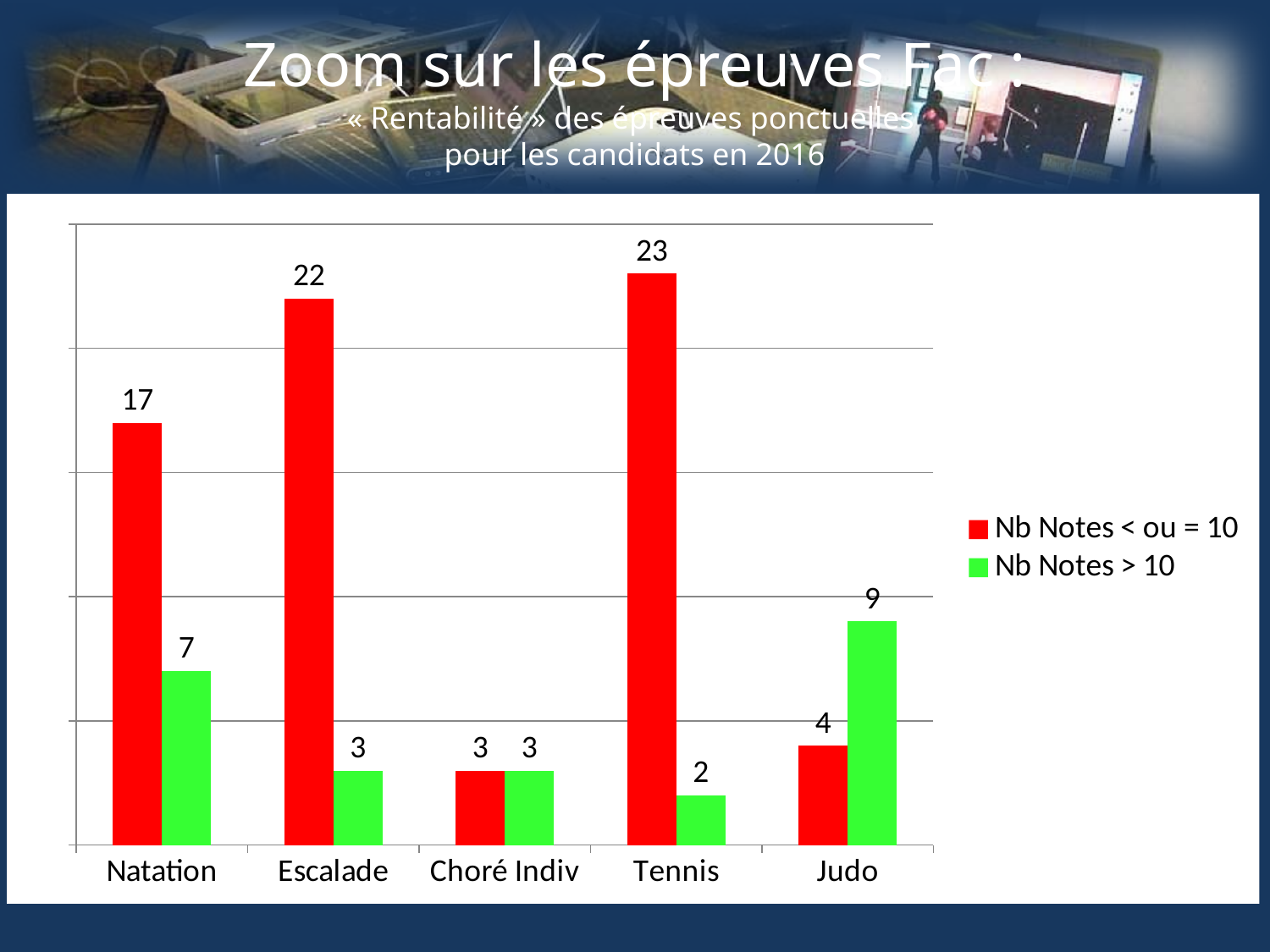
Which colour represents the series "Nb Notes > 10"? Green How many categories are shown on the x axis? 5 What is the value of "Nb Notes > 10" for Judo? 9 What is the value of "Nb Notes > 10" for Natation? 7 Which is larger for Judo: "Nb Notes < ou = 10" or "Nb Notes > 10"? Nb Notes > 10 Which category has the highest value for "Nb Notes < ou = 10"? Tennis What kind of chart is shown on the slide? Bar chart Which category has the lowest value for "Nb Notes > 10"? Tennis What is the total of "Nb Notes < ou = 10" and "Nb Notes > 10" for Natation? 24 What is the difference between "Nb Notes < ou = 10" and "Nb Notes > 10" for Escalade? 19 What is the value of "Nb Notes < ou = 10" for Tennis? 23 How many series does the legend list? 2